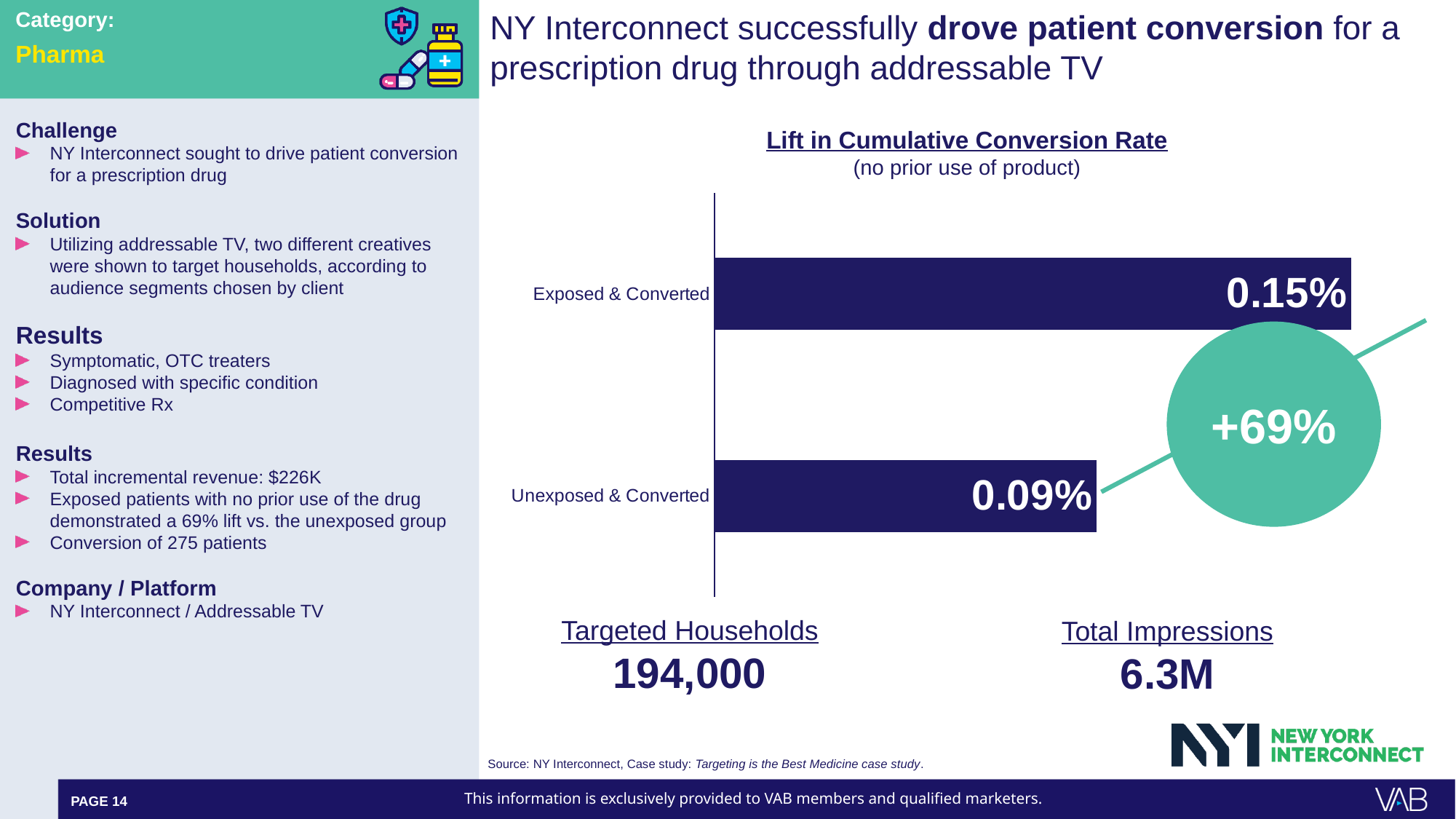
What is the difference between the Exposed & Converted and Unexposed & Converted conversion rates? 0.06% Is the value for Exposed & Converted larger or smaller than the value for Unexposed & Converted? larger What lift percentage is shown in the circle callout on the chart? +69% How many categories are shown in the chart? 2 Which category has the lower conversion rate? Unexposed & Converted What is the conversion rate for Exposed & Converted? 0.15% What is the title of the chart? Lift in Cumulative Conversion Rate Which category has the higher conversion rate? Exposed & Converted What is the conversion rate for Unexposed & Converted? 0.09% What kind of chart is shown on the slide? bar chart